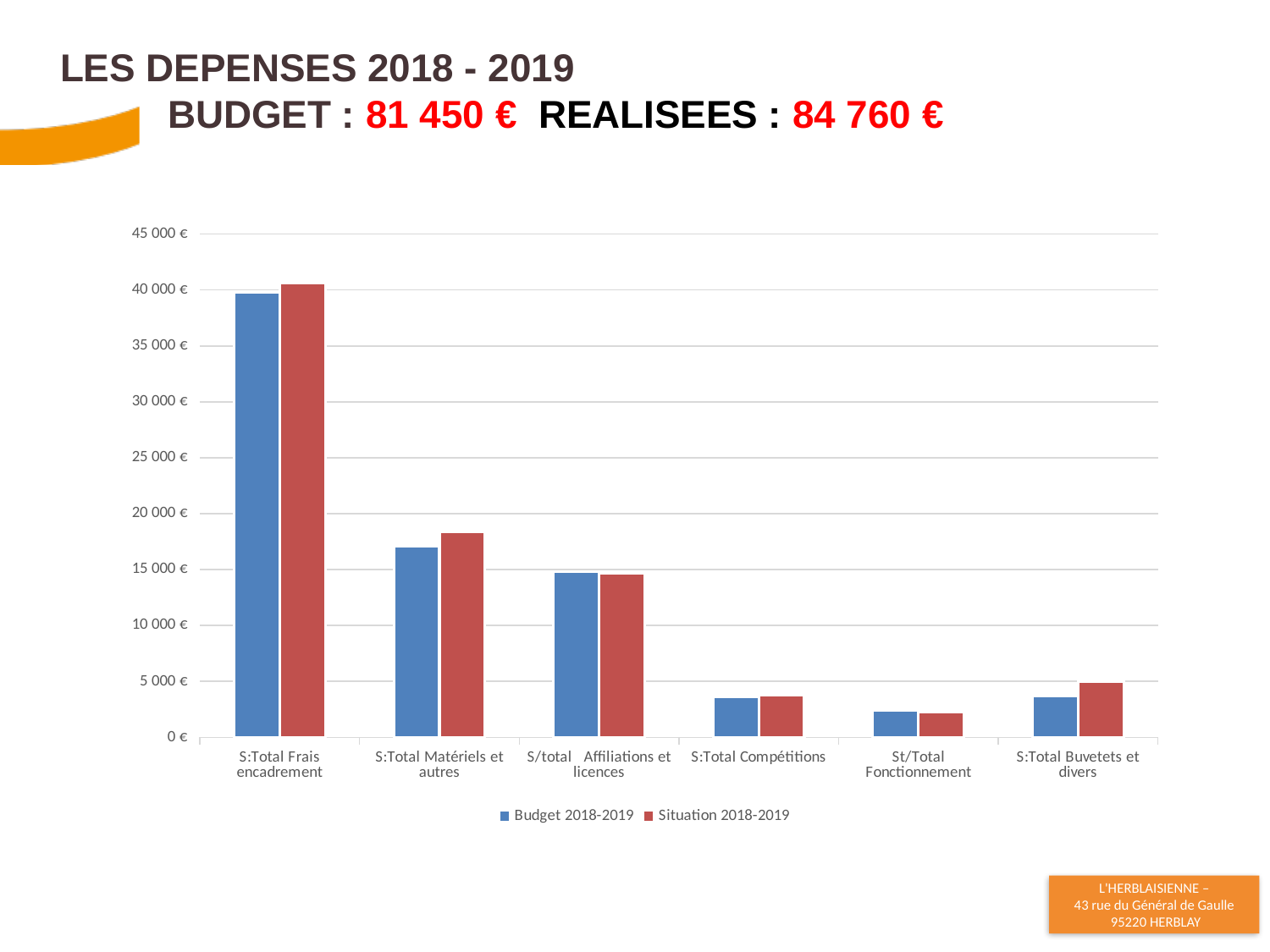
For S:Total Buvetets et divers, which is larger: Budget 2018-2019 or Situation 2018-2019? Situation 2018-2019 For S:Total Matériels et autres, which is larger: Budget 2018-2019 or Situation 2018-2019? Situation 2018-2019 Which category has the lowest Situation 2018-2019 value? St/Total Fonctionnement What are the two series named in the legend? Budget 2018-2019 and Situation 2018-2019 Which category has the highest Budget 2018-2019 value? S:Total Frais encadrement How many categories are shown on the x axis? 6 Is the Situation 2018-2019 value for S:Total Matériels et autres greater or less than 15 000 €? greater Is the Budget 2018-2019 value for S:Total Compétitions greater or less than 5 000 €? less What kind of chart is shown on the slide? bar chart Is the Budget 2018-2019 value for S:Total Frais encadrement greater or less than 35 000 €? greater How many series does the legend list? 2